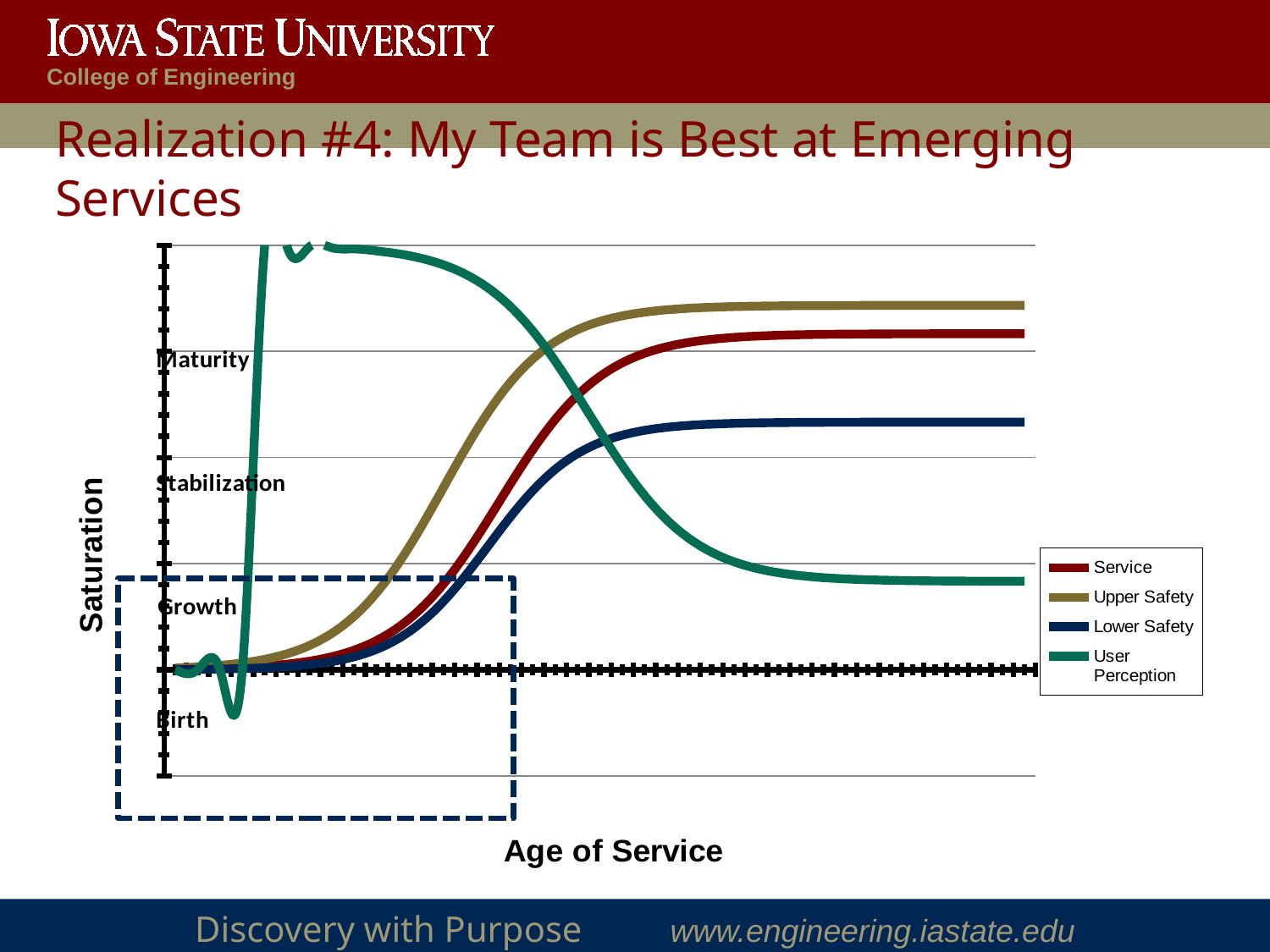
Does the User Perception line rise or fall over the right half of the chart? Falls What is the title of the x axis? Age of Service What is the title of the y axis? Saturation Which series is drawn in green? User Perception At the right end of the chart, which series has the lowest value? User Perception Does the Service line rise or fall as Age of Service increases? Rises At the right end of the chart, which is higher: Upper Safety or Service? Upper Safety At the right end of the chart, which series has the highest value? Upper Safety How many stage labels (Birth, Growth, etc.) are shown along the y axis? 4 At the right end of the chart, which is lower: Lower Safety or Service? Lower Safety How many series does the legend list? 4 What kind of chart is shown on the slide? Line chart